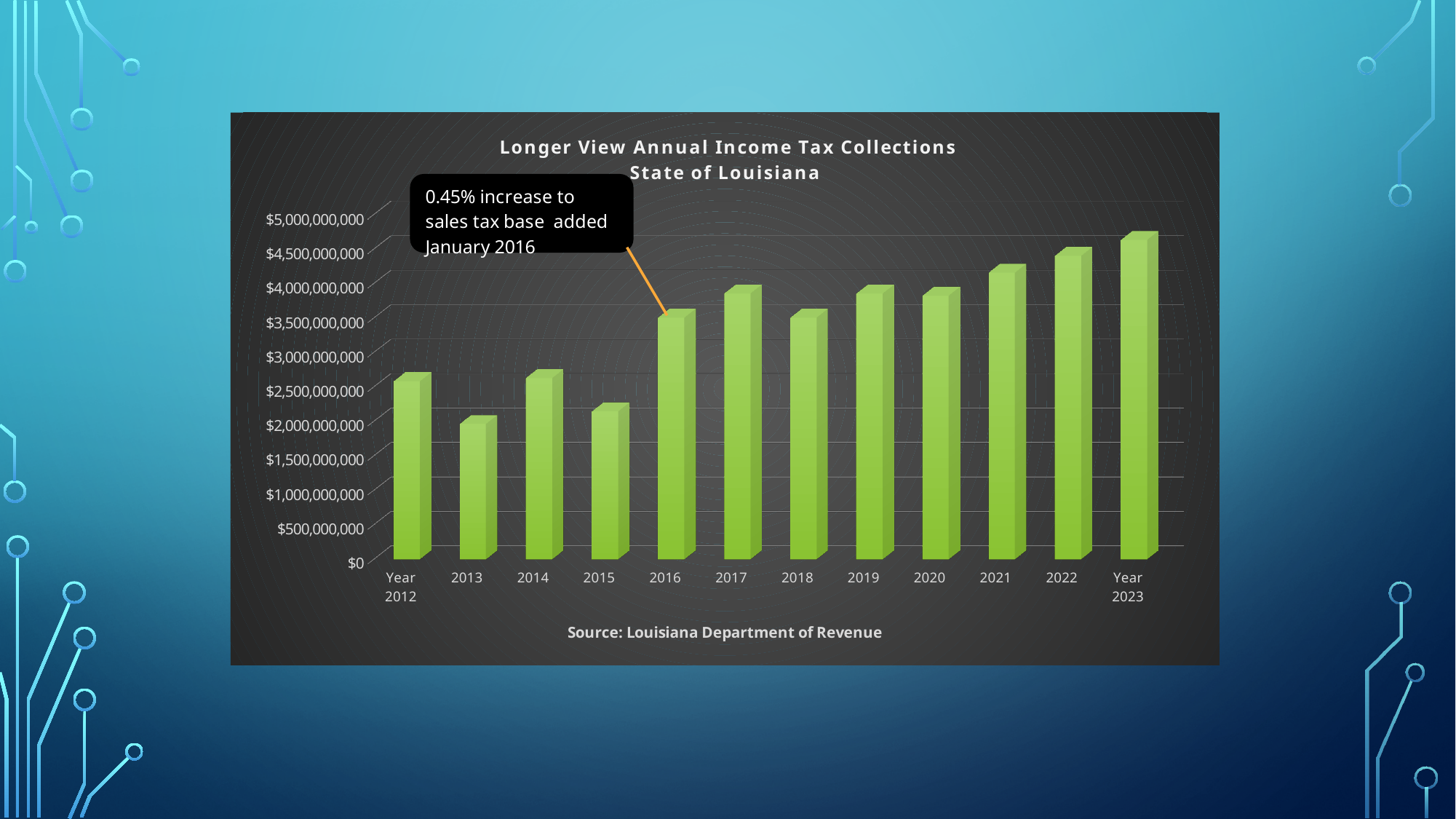
According to the annotation, what happened in January 2016? 0.45% increase to sales tax base added Which year has the larger value, 2013 or 2014? 2014 Do income tax collections generally rise or fall from 2012 to 2023? Rise Is the value for 2022 greater or less than $4,000,000,000? greater How many years are plotted on the chart? 12 Which year has the larger value, 2017 or 2018? 2017 What kind of chart is shown on the slide? Bar chart Is the value for 2015 greater or less than $2,500,000,000? less Which year has the highest income tax collections? 2023 Is the value for 2016 greater or less than $3,000,000,000? greater Which year has the lowest income tax collections? 2013